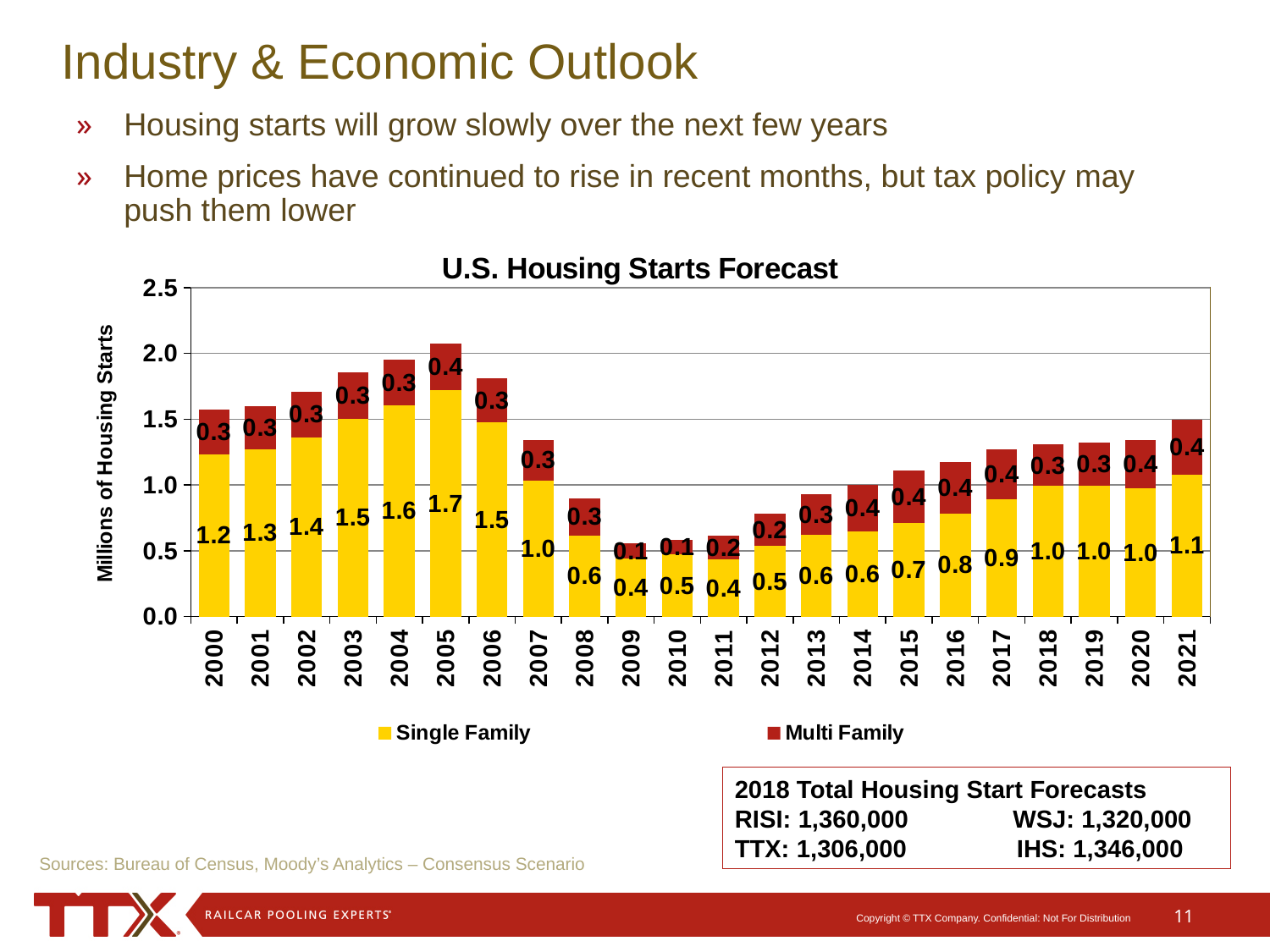
What is the total of the stacked bar for 2021? 1.5 What is the difference between the Single Family values for 2005 and 2000? 0.5 What is the Multi Family value for 2011? 0.2 How many years are shown on the x axis of the U.S. Housing Starts Forecast chart? 22 Which year has the highest Single Family value? 2005 Which is larger, the Single Family value for 2004 or for 2017? 2004 What type of chart is shown on the slide? Stacked bar chart Is the total housing starts value for 2005 greater or less than 2.0? greater What is the label on the y axis of the chart? Millions of Housing Starts How many series does the legend of the U.S. Housing Starts Forecast chart list? 2 What is the Single Family value for 2005? 1.7 What is the Single Family value for 2021? 1.1